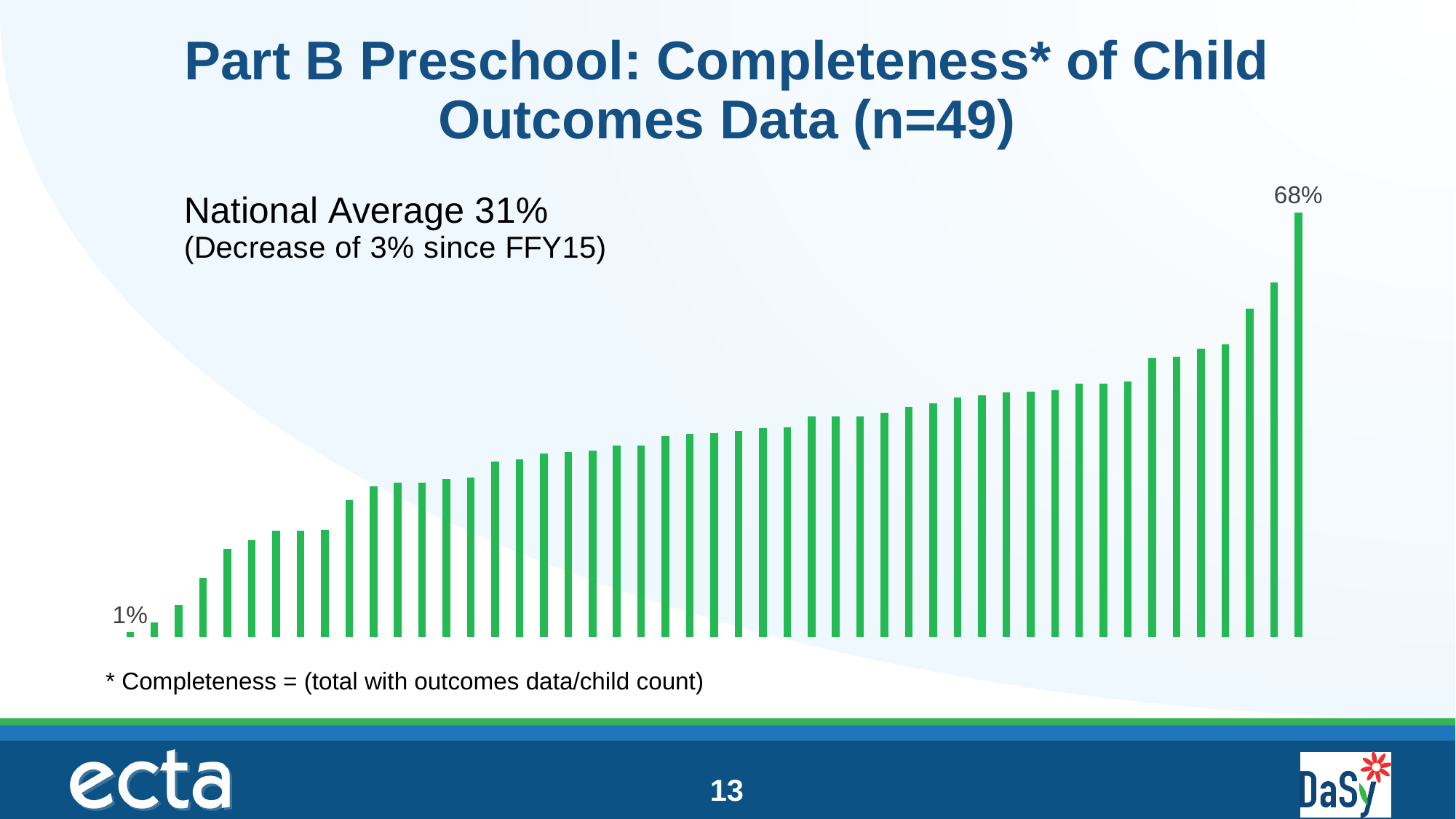
What kind of chart is shown on the slide? Bar chart Do the bar values rise or fall from left to right across the chart? Rise What is the lowest value shown in the chart? 1% What is the difference between the highest labelled value (68%) and the lowest labelled value (1%) in the chart? 67% What is the title of the chart on the slide? Part B Preschool: Completeness* of Child Outcomes Data (n=49) How many states or entities are represented in the chart, according to the title? 49 What is the highest value shown in the chart? 68% Which bar is taller, the leftmost bar or the rightmost bar? The rightmost bar What is the national average completeness stated on the slide? 31%